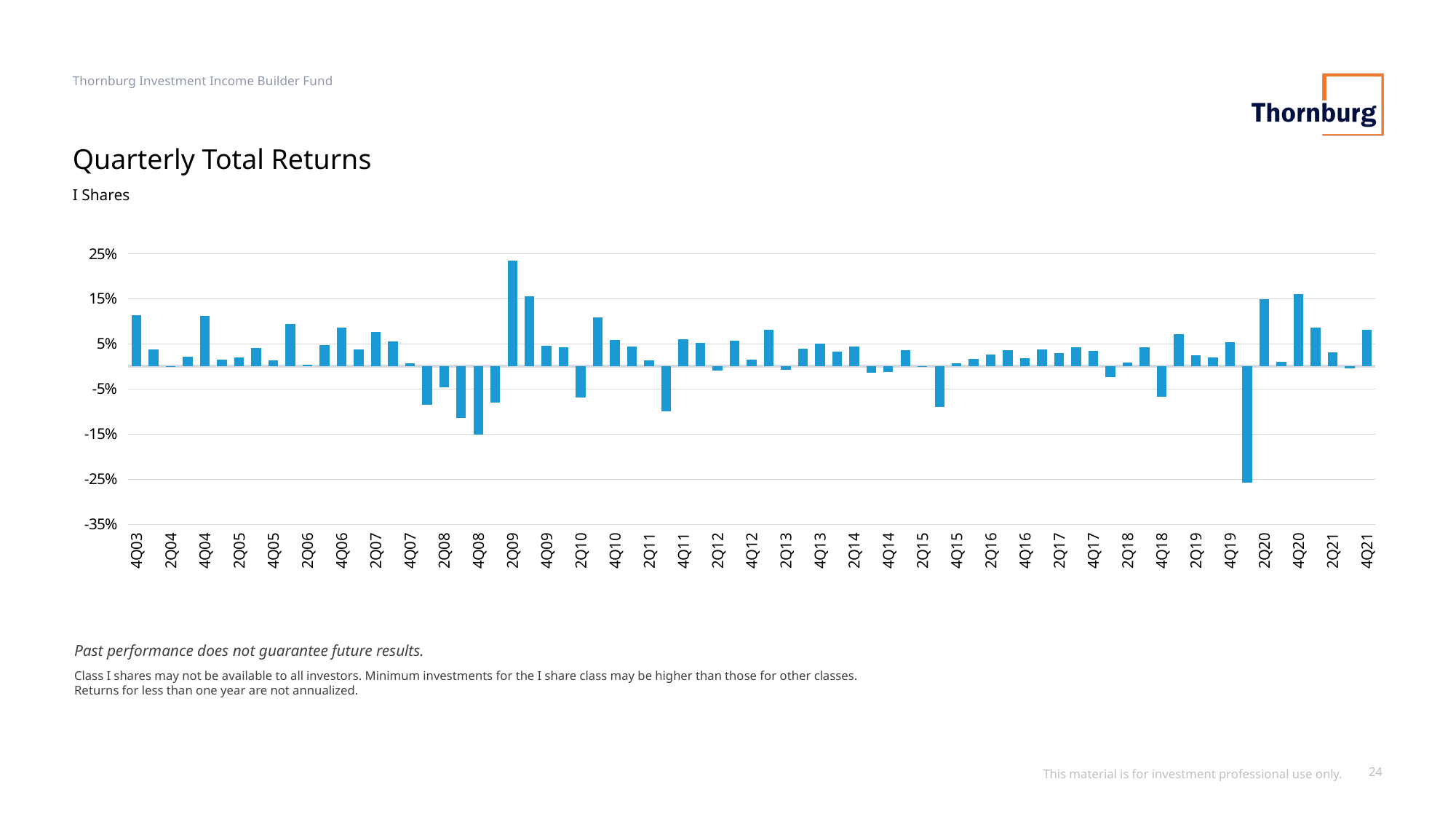
Which is larger, the return for 2Q09 or the return for 4Q03? 2Q09 Which labeled quarter has the highest return on the chart? 2Q09 What is the title of the chart? Quarterly Total Returns Is the value for 2Q09 greater or less than 15%? greater Is the value for 4Q04 greater or less than 5%? greater Is the value for 4Q21 greater or less than 5%? greater Which is larger, the return for 4Q10 or the return for 2Q10? 4Q10 Which share class does the chart show returns for? I Shares What kind of chart is shown on the slide? bar chart